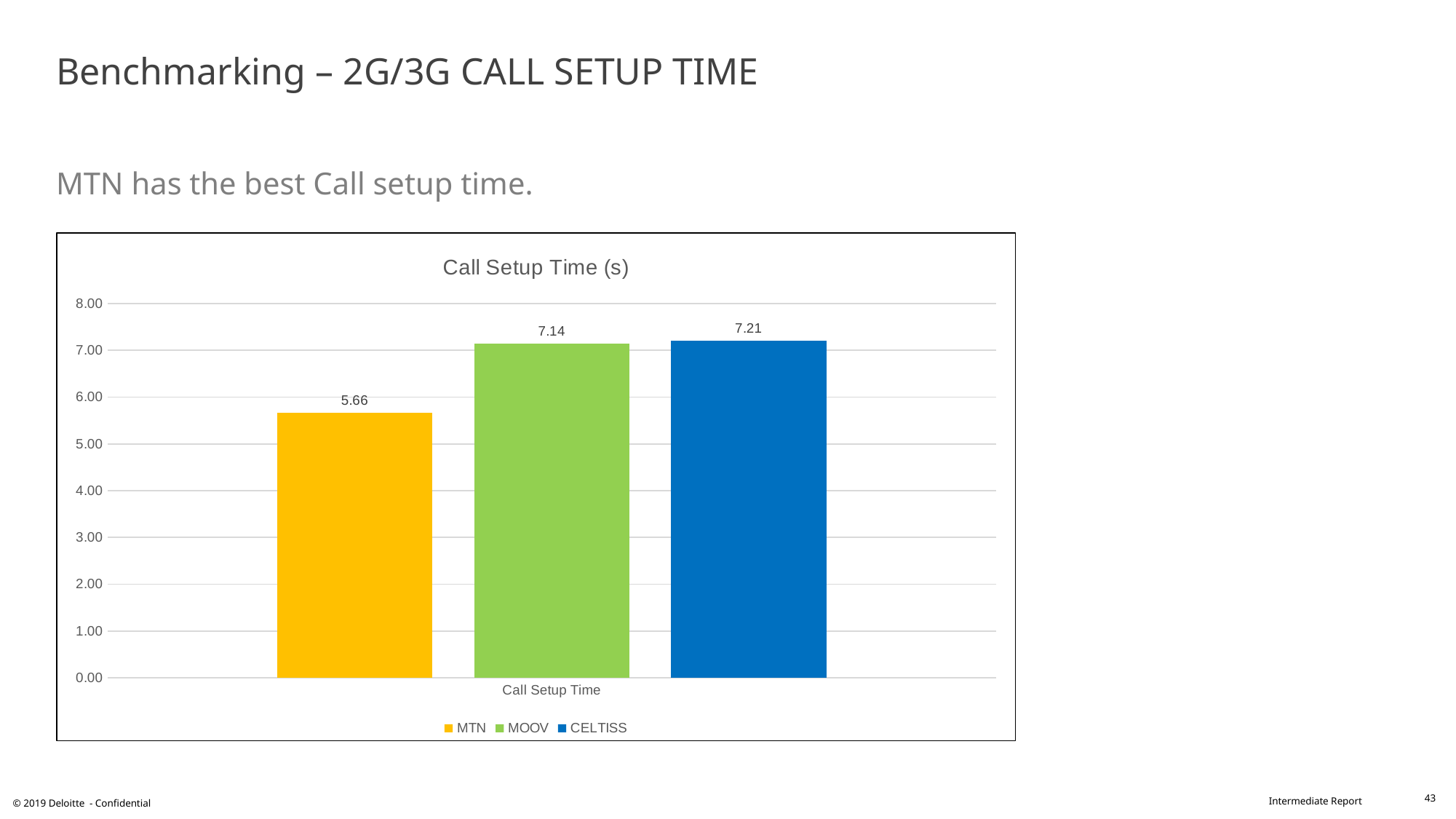
Which operator has the lowest call setup time? MTN Which has a larger call setup time, MTN or MOOV? MOOV Is the call setup time for CELTISS greater or less than 7.00? greater What is the title of the chart? Call Setup Time (s) What is the difference in call setup time between MOOV and MTN? 1.48 What is the difference in call setup time between CELTISS and MTN? 1.55 What is the call setup time for CELTISS? 7.21 How many series does the legend list? 3 What is the call setup time for MOOV? 7.14 Is the call setup time for MTN greater or less than 6.00? less What is the call setup time for MTN? 5.66 What kind of chart is shown on the slide? Bar chart